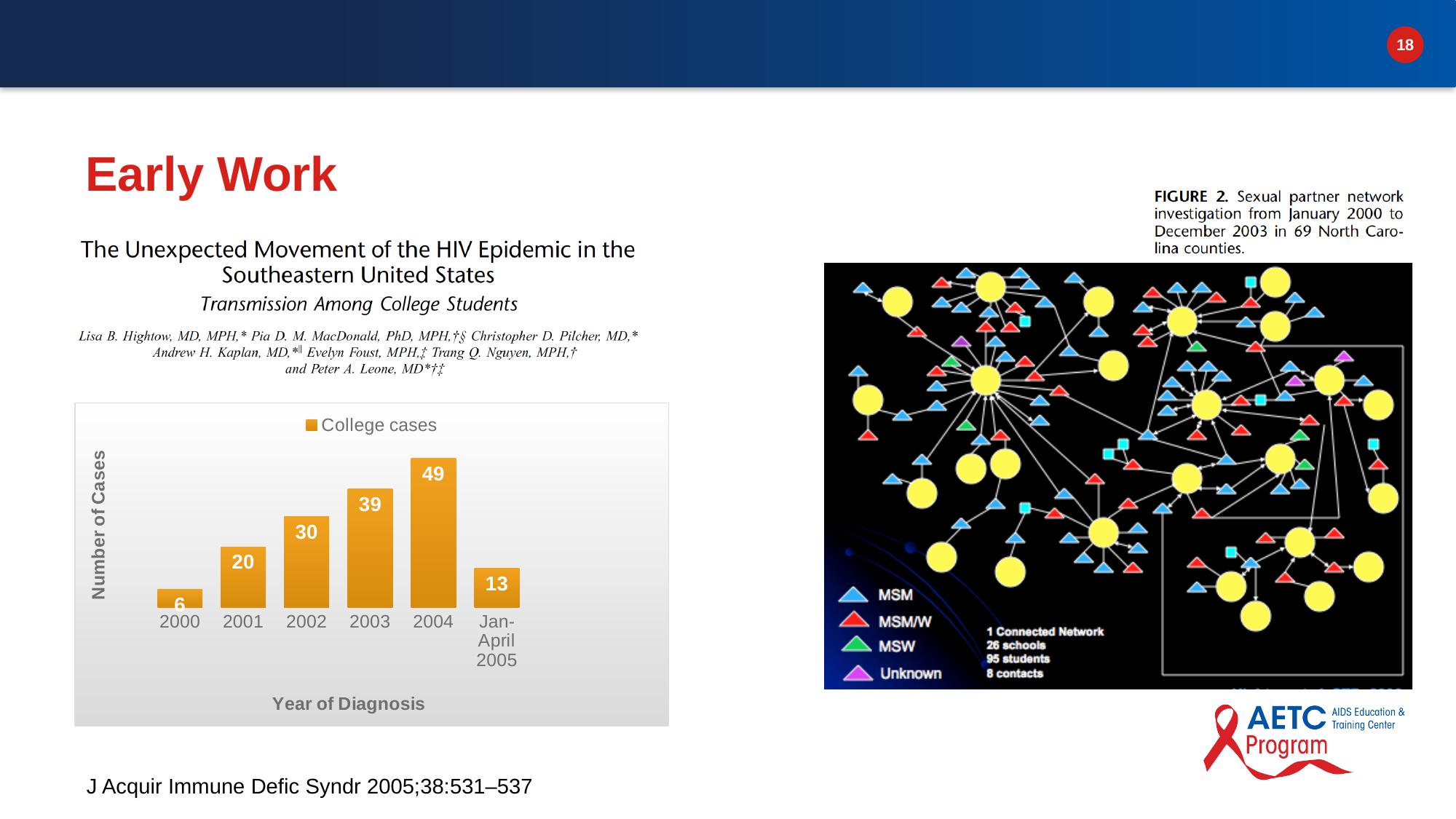
In the College cases bar chart, which year of diagnosis has the highest number of cases? 2004 In the College cases bar chart, which has more cases, 2002 or 2003? 2003 How many series does the legend of the College cases chart list? 1 What kind of chart is used to show the college cases by year of diagnosis? bar chart In the College cases bar chart, how many cases were diagnosed in Jan-April 2005? 13 In the College cases bar chart, how many cases were diagnosed in 2004? 49 In the College cases bar chart, how many cases were diagnosed in 2002? 30 How many year-of-diagnosis categories are shown in the College cases bar chart? 6 What is the label of the y axis in the College cases bar chart? Number of Cases In the College cases bar chart, do the values rise or fall from 2000 to 2004? rise In the College cases bar chart, which year of diagnosis has the lowest number of cases? 2000 In the College cases bar chart, what is the difference in cases between 2003 and 2001? 19